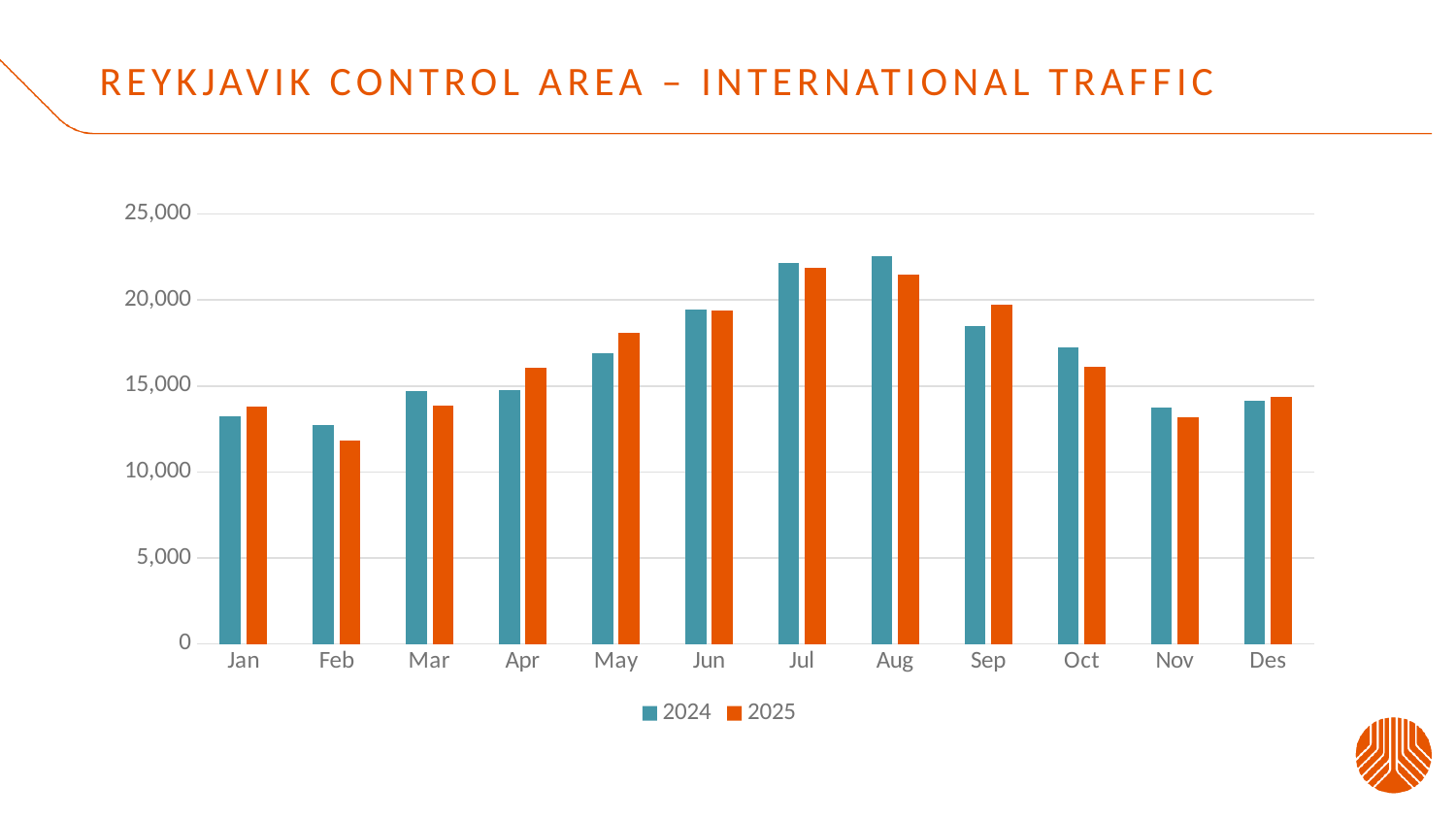
Is the value for Aug 2024 greater or less than 20,000? greater Is the value for May 2025 greater or less than 15,000? greater How many series does the legend list? 2 What kind of chart is shown on the slide? bar chart Is the value for Feb 2025 greater or less than 15,000? less Do the 2024 values rise or fall from Aug to Nov? fall In Apr, which series has the larger value, 2024 or 2025? 2025 Which month has the lowest value for 2025? Feb Which month has the highest value for 2024? Aug How many months are shown on the x axis? 12 In Oct, which series has the larger value, 2024 or 2025? 2024